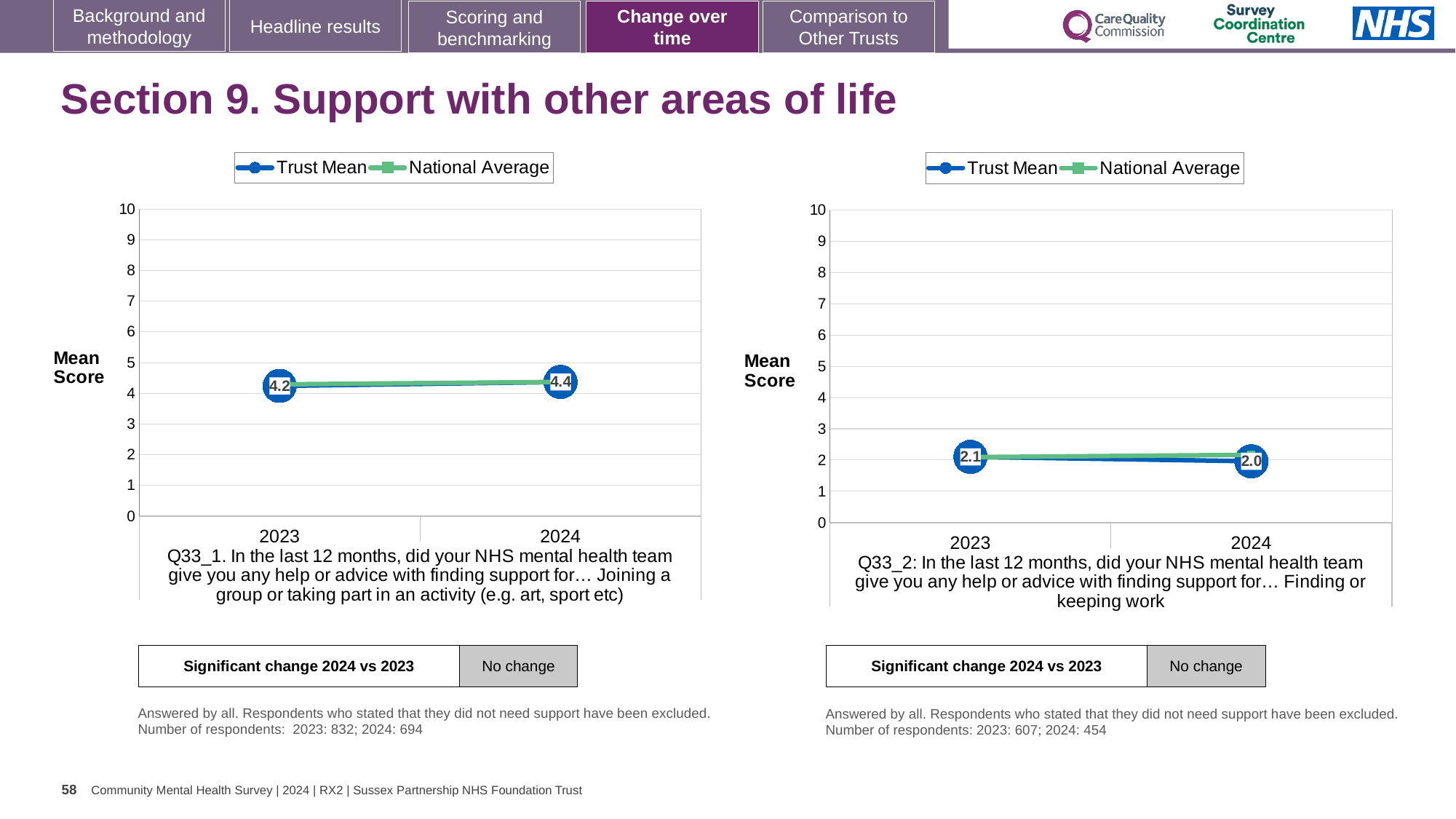
On the left chart (Q33_1), what is the Trust Mean for 2024? 4.4 On the left chart (Q33_1), what is the difference between the Trust Mean for 2024 and 2023? 0.2 On the right chart (Q33_2), what is the Trust Mean for 2023? 2.1 On the left chart (Q33_1), does the Trust Mean rise or fall from 2023 to 2024? rise How many series does the legend of the right chart (Q33_2) list? 2 What type of chart is the left chart (Q33_1)? line chart On the right chart (Q33_2), does the Trust Mean rise or fall from 2023 to 2024? fall On the right chart (Q33_2), what is the Trust Mean for 2024? 2.0 On the left chart (Q33_1), is the Trust Mean for 2024 greater or less than 5? less How many years are plotted on the x axis of the right chart (Q33_2)? 2 On the right chart (Q33_2), what is the difference between the Trust Mean for 2023 and 2024? 0.1 On the left chart (Q33_1), what is the Trust Mean for 2023? 4.2